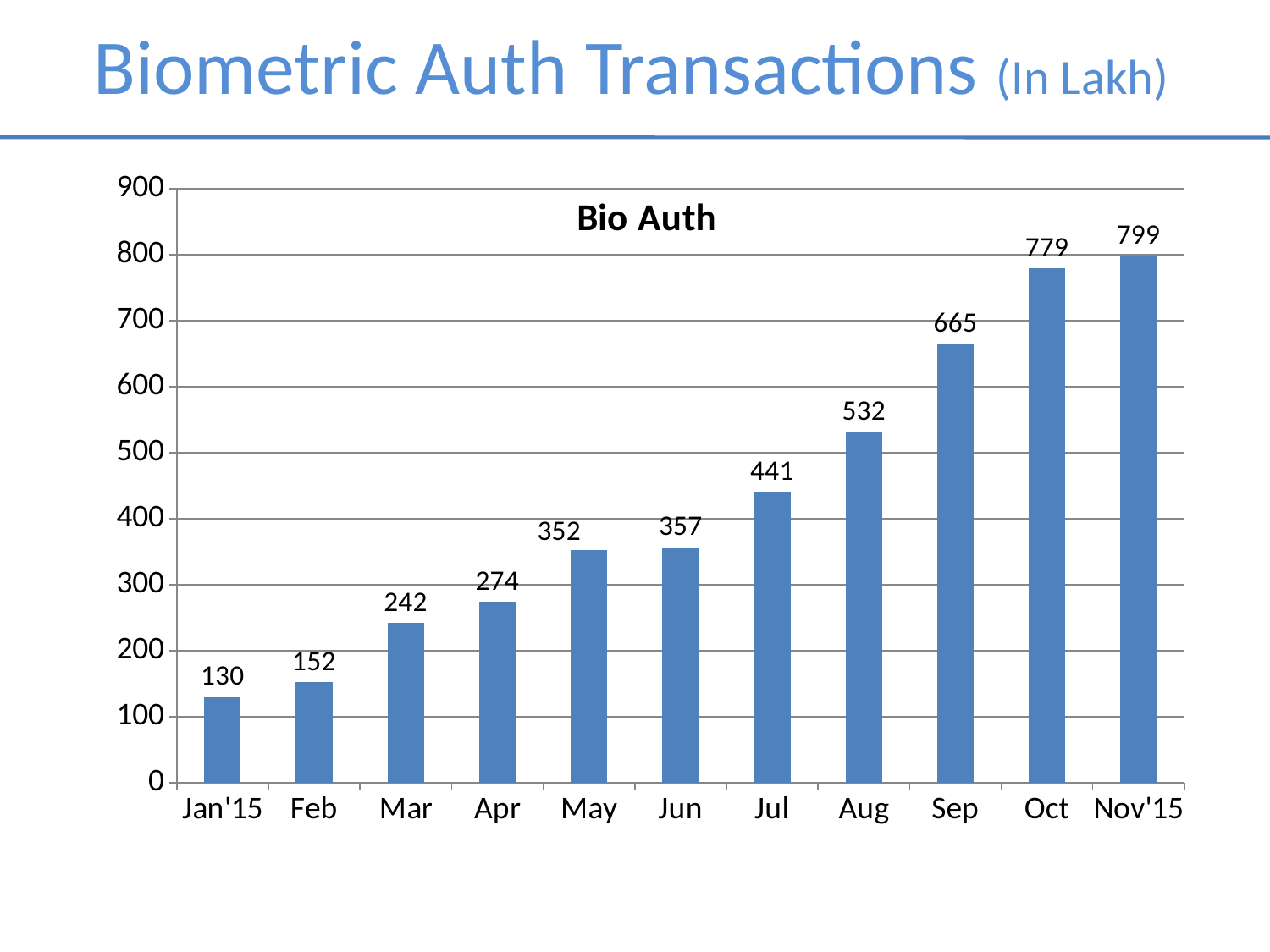
What is the difference between the values for Oct and Sep? 114 Which is larger, the value for May or the value for Jun? Jun What is the value for Jul? 441 What is the difference between the values for Aug and Jan'15? 402 What kind of chart is shown on the slide? bar chart What is the value for Mar? 242 How many months are shown on the x axis? 11 Which month has the highest value? Nov'15 Which month has the lowest value? Jan'15 Is the value for Sep greater or less than 600? greater What is the title shown inside the chart area? Bio Auth Do the values rise or fall from Jan'15 to Nov'15? rise